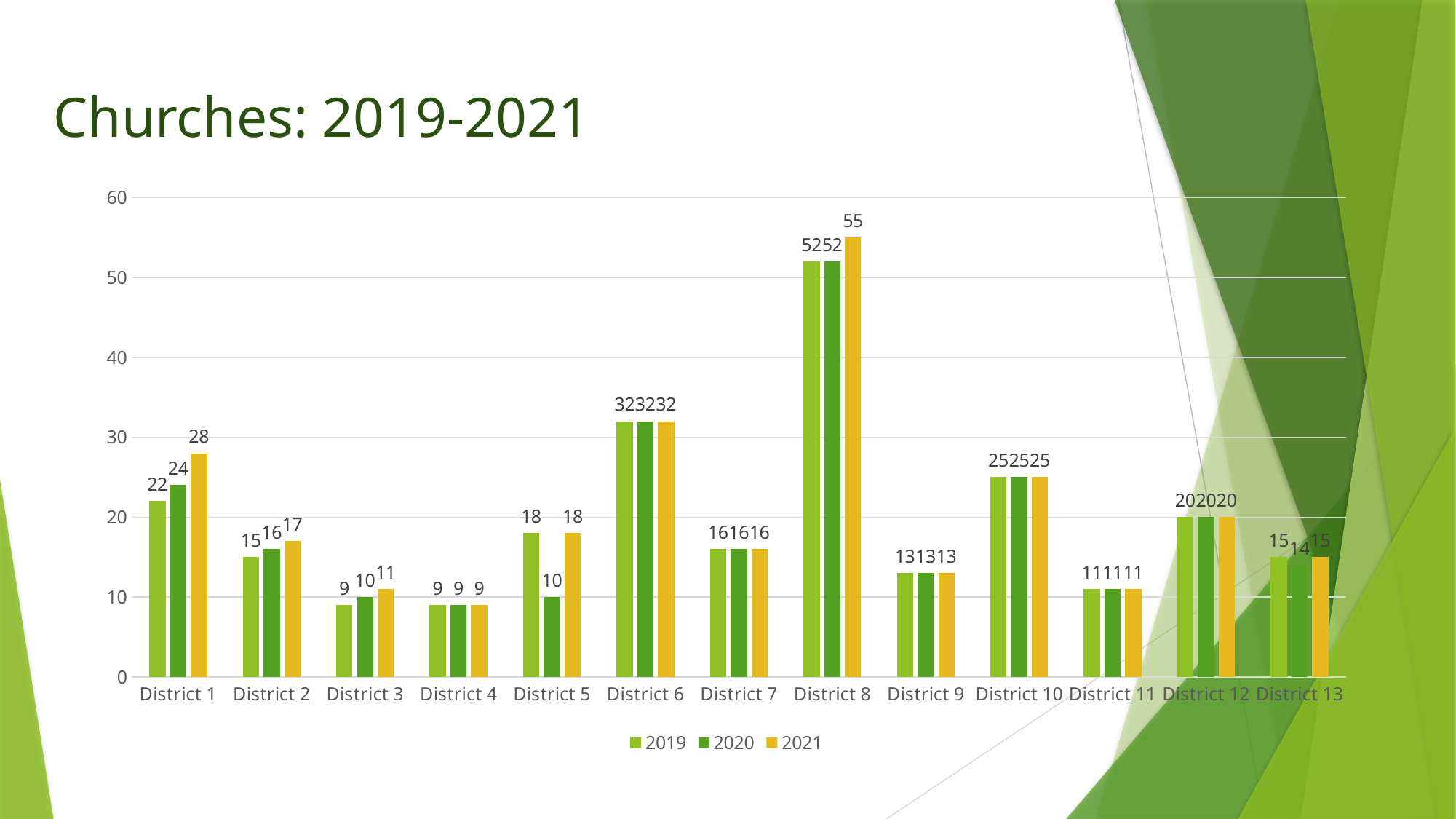
How many districts are shown on the x axis? 13 What is the value for District 8 in the 2021 series? 55 What is the difference between the 2021 and 2020 values for District 8? 3 What is the value for District 1 in the 2021 series? 28 What kind of chart is shown on the slide? Bar chart What is the title of the chart? Churches: 2019-2021 What is the difference between the 2021 and 2019 values for District 1? 6 Which district has the highest value in the 2019 series? District 8 Which is larger: the 2019 value for District 6 or the 2019 value for District 10? District 6 Which district has the lowest value in the 2021 series? District 4 How many series does the legend list? 3 What is the value for District 5 in the 2020 series? 10